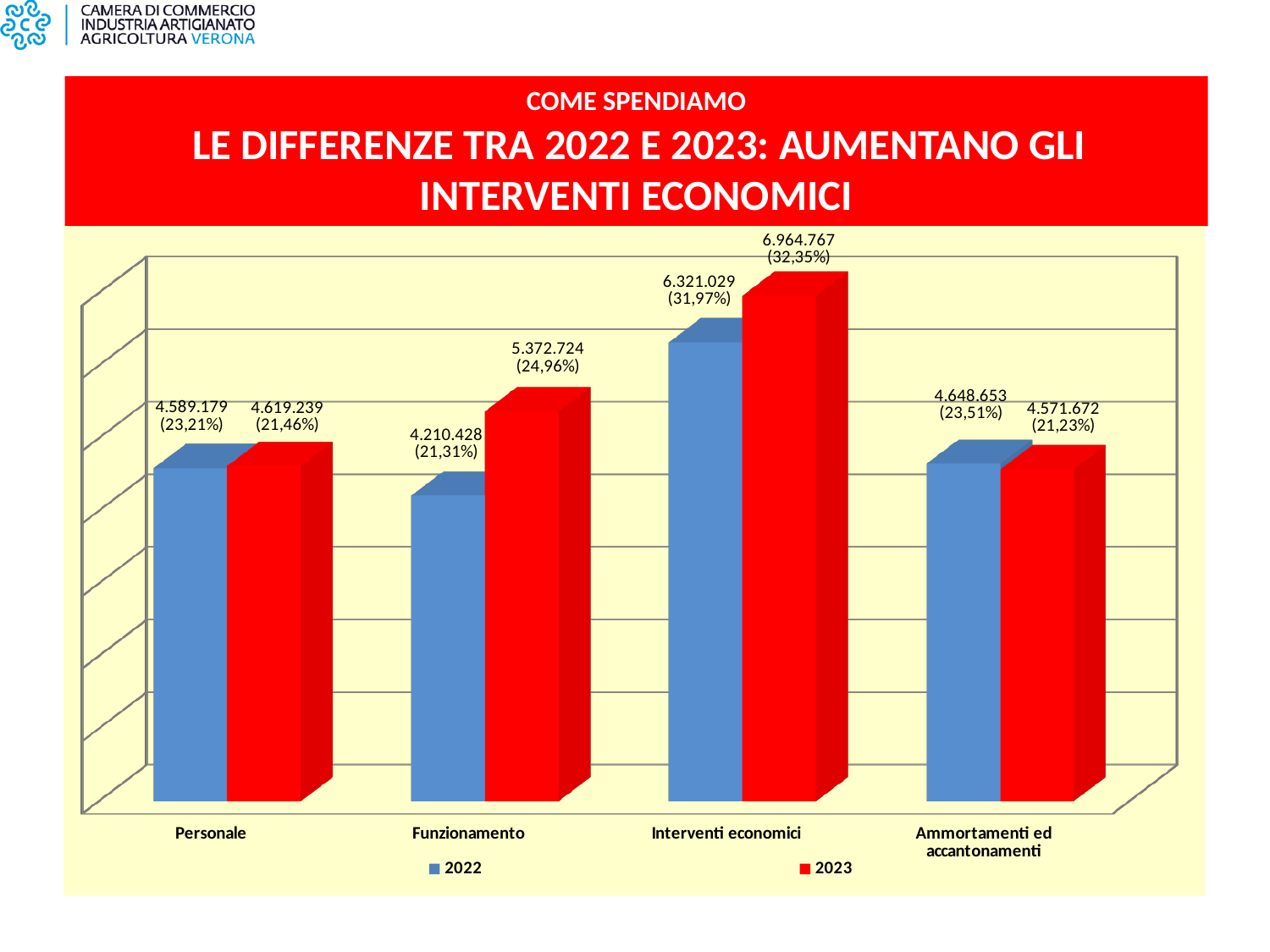
What is the difference between the 2023 and 2022 values for Interventi economici? 643.738 What is the difference between the 2023 and 2022 values for Funzionamento? 1.162.296 How many series does the legend list? 2 What is the 2022 value for Interventi economici? 6.321.029 For Ammortamenti ed accantonamenti, which year has the larger value, 2022 or 2023? 2022 What kind of chart is shown on the slide? Bar chart What is the 2023 value for Funzionamento? 5.372.724 How many categories are shown on the x axis? 4 Which category has the lowest 2022 value? Funzionamento What is the 2022 value for Ammortamenti ed accantonamenti? 4.648.653 Which category has the highest 2023 value? Interventi economici What percentage is shown for Personale in 2023? 21,46%